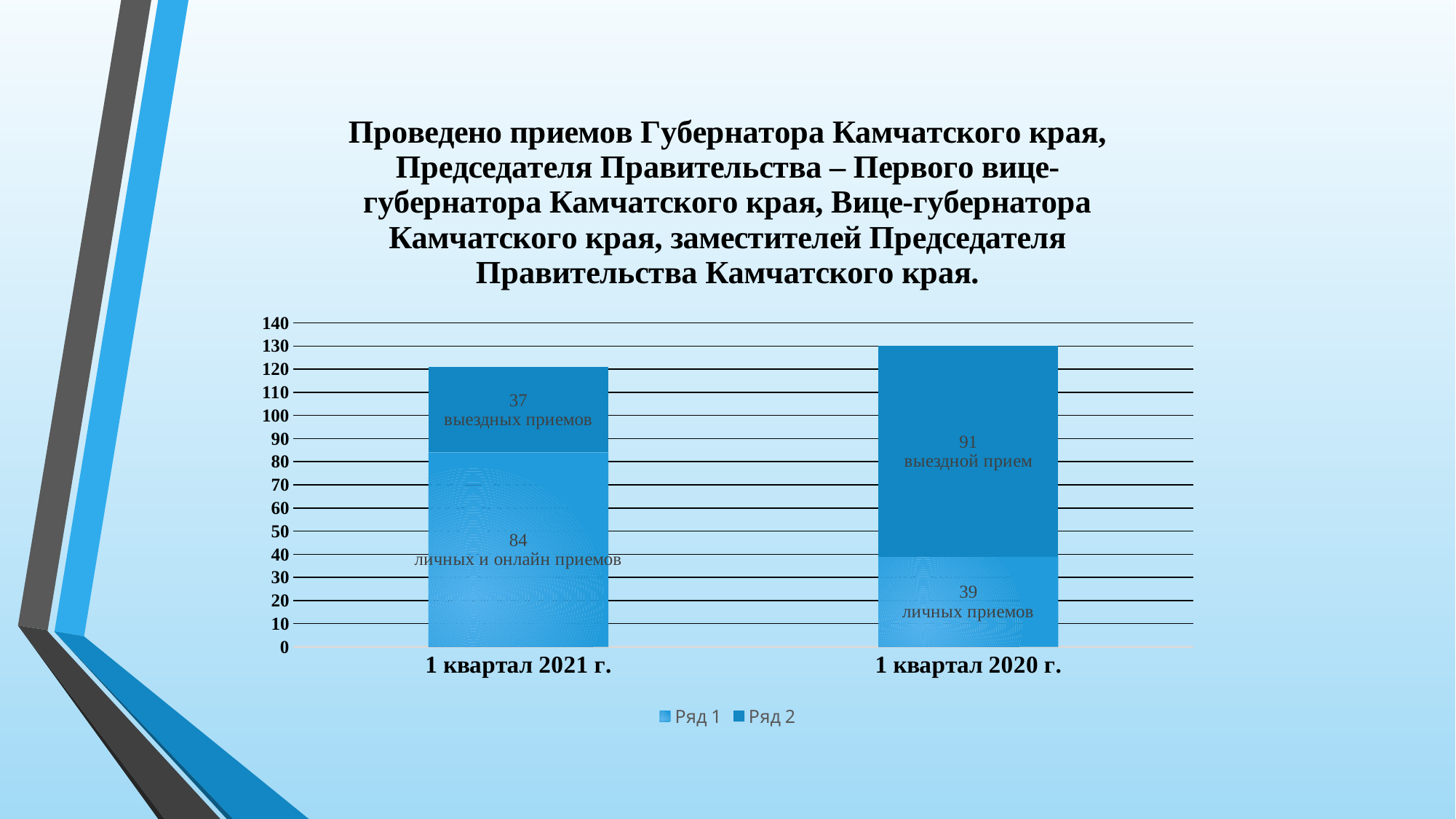
Which is larger: the Ряд 1 value for 1 квартал 2021 г. or the Ряд 1 value for 1 квартал 2020 г.? 1 квартал 2021 г. What kind of chart is shown on the slide? stacked bar chart What is the value of the Ряд 2 segment (выездной прием) for 1 квартал 2020 г.? 91 What is the total of the stacked bar for 1 квартал 2021 г.? 121 What is the value of the Ряд 1 segment (личных приемов) for 1 квартал 2020 г.? 39 What is the value of the Ряд 1 segment (личных и онлайн приемов) for 1 квартал 2021 г.? 84 What is the total of the stacked bar for 1 квартал 2020 г.? 130 How many categories are shown on the x axis of the chart? 2 What are the two series names listed in the chart legend? Ряд 1 and Ряд 2 What is the difference between the Ряд 2 values for 1 квартал 2020 г. and 1 квартал 2021 г.? 54 What is the value of the Ряд 2 segment (выездных приемов) for 1 квартал 2021 г.? 37 How many series does the chart legend list? 2